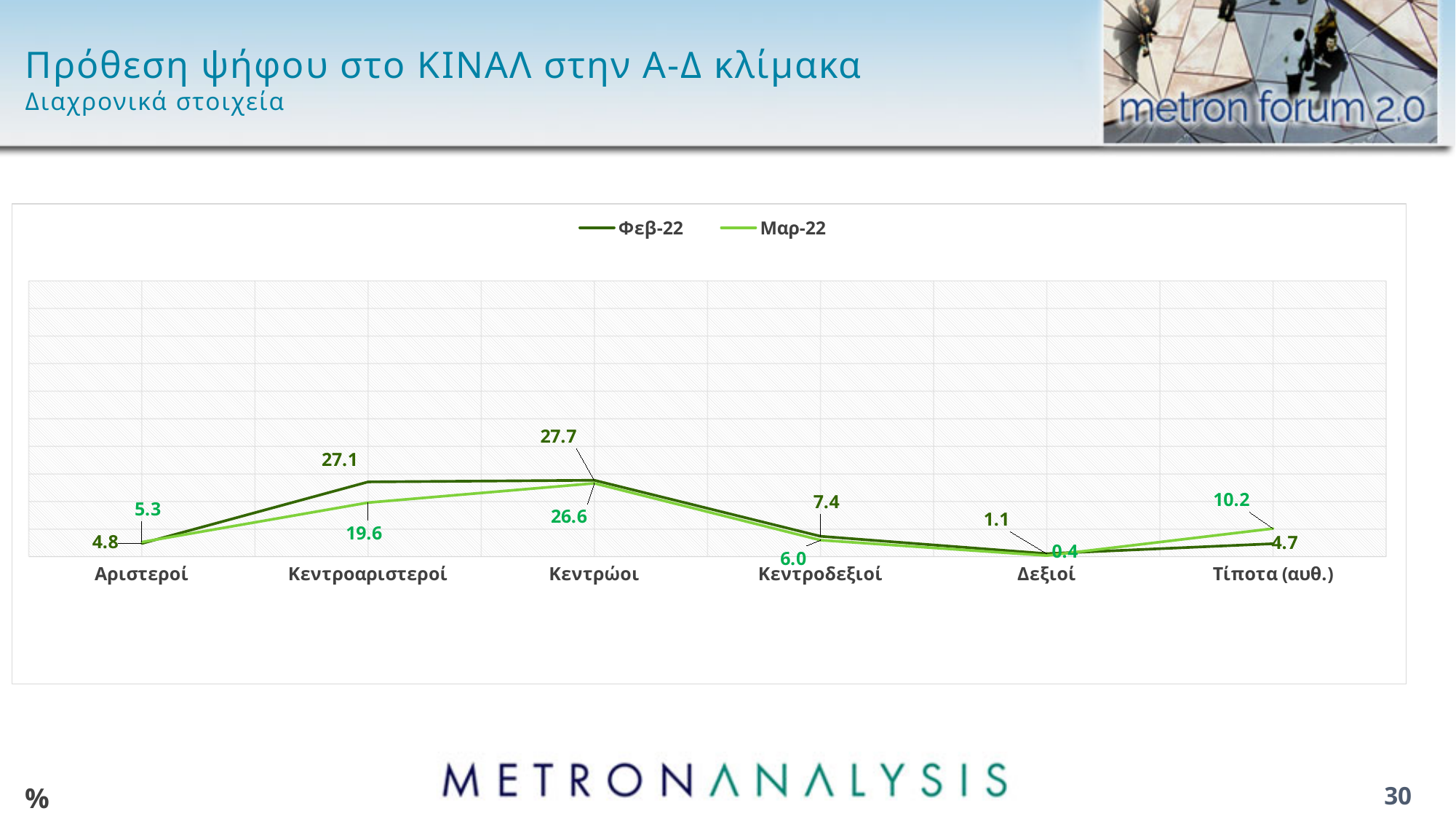
What kind of chart is shown on the slide? Line chart Which category has the lowest Μαρ-22 value? Δεξιοί How many series does the legend list? 2 Which category has the highest Φεβ-22 value? Κεντρώοι What is the Μαρ-22 value for Δεξιοί? 0.4 What is the Μαρ-22 value for Τίποτα (αυθ.)? 10.2 What is the Φεβ-22 value for Κεντροδεξιοί? 7.4 What is the difference between the Φεβ-22 and Μαρ-22 values for Κεντροαριστεροί? 7.5 How many categories are shown on the x axis? 6 Which series is drawn in the lighter green line? Μαρ-22 Which is larger for Τίποτα (αυθ.): the Φεβ-22 value or the Μαρ-22 value? Μαρ-22 What is the Φεβ-22 value for Κεντροαριστεροί? 27.1